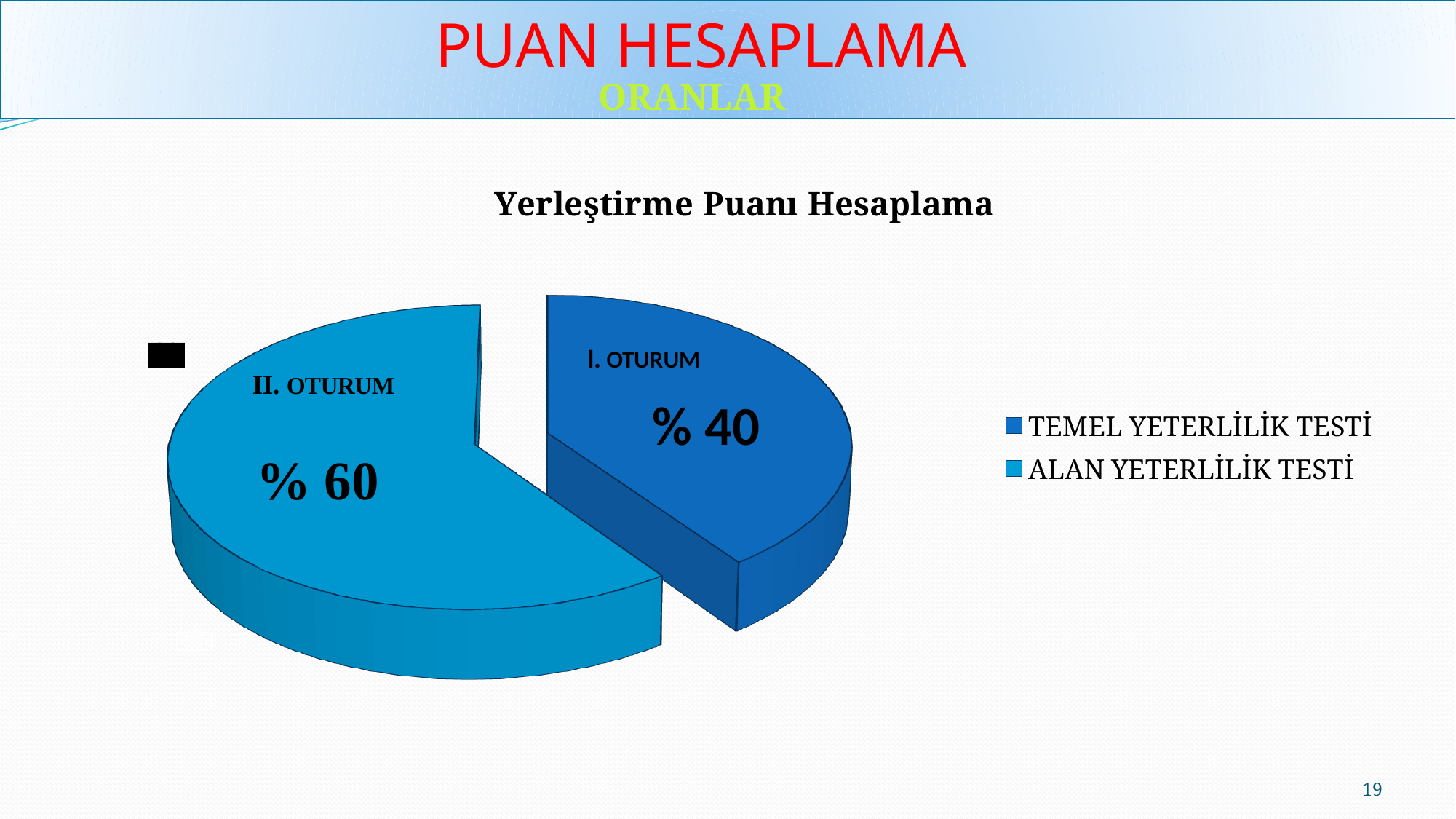
What is the title of the chart? Yerleştirme Puanı Hesaplama What is the difference in percentage points between the II. OTURUM slice and the I. OTURUM slice? 20 What kind of chart is shown on the slide? Pie chart What share of the pie is labelled II. OTURUM? % 60 Which slice is the smallest in the pie chart? I. OTURUM Which slice is the largest in the pie chart? II. OTURUM Which is larger, the I. OTURUM slice or the II. OTURUM slice? II. OTURUM What share of the pie is labelled I. OTURUM? % 40 How many slices does the pie chart have? 2 Is the share for I. OTURUM greater or less than 50%? less Which legend entry corresponds to the darker blue slice? TEMEL YETERLİLİK TESTİ How many entries does the chart legend list? 2